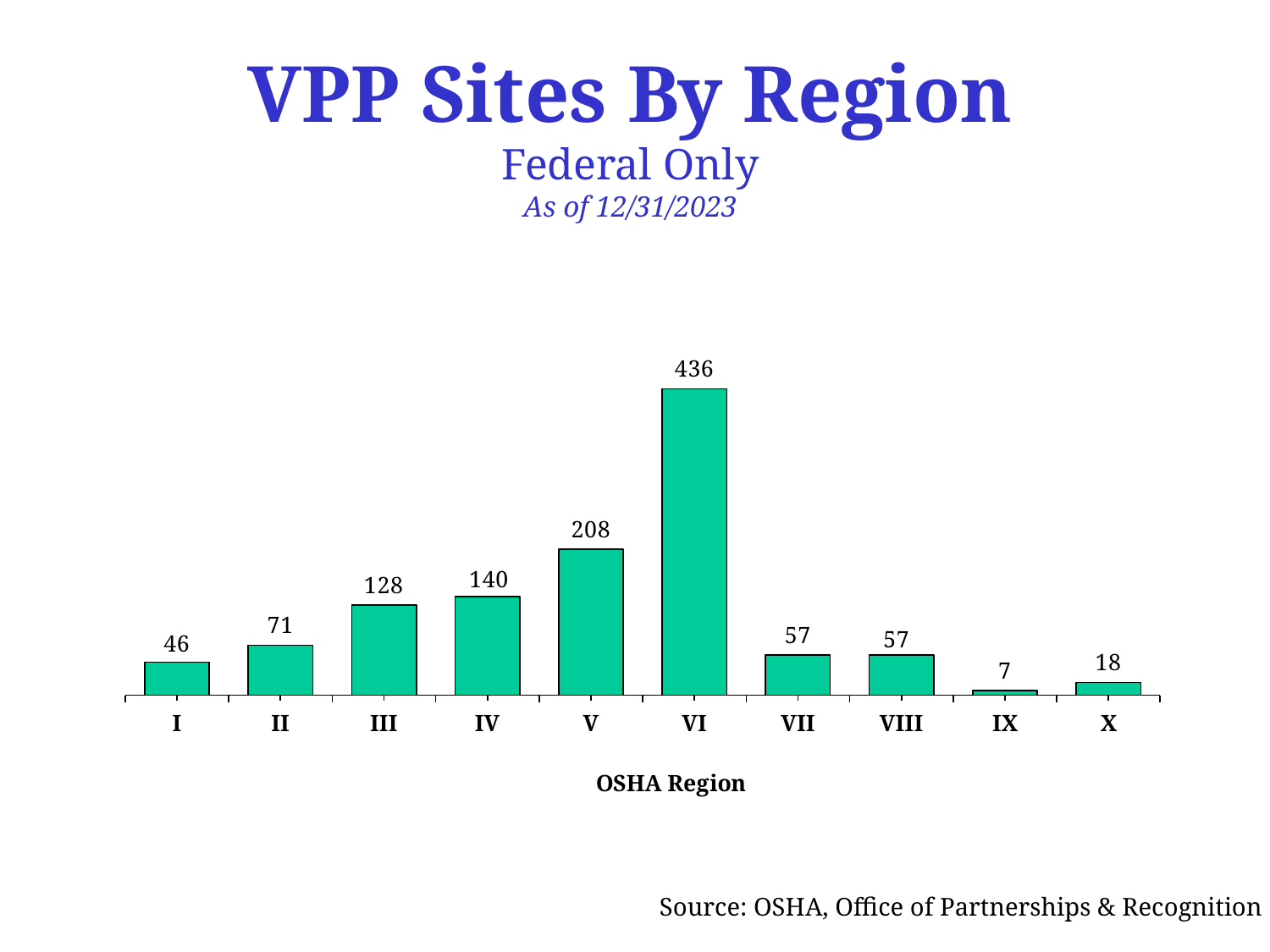
What is the x-axis title of the chart? OSHA Region Which has more VPP sites, Region II or Region I? Region II How many VPP sites are in OSHA Region VI? 436 What is the difference between the values for Region IV and Region III? 12 How many OSHA regions are shown on the x axis? 10 What kind of chart is shown on the slide? Bar chart What is the value shown for Region X? 18 Which two regions have the same value of 57? VII and VIII What is the value shown for Region III? 128 What is the difference between the values for Region VI and Region V? 228 Which OSHA region has the highest number of VPP sites? VI Which OSHA region has the lowest number of VPP sites? IX